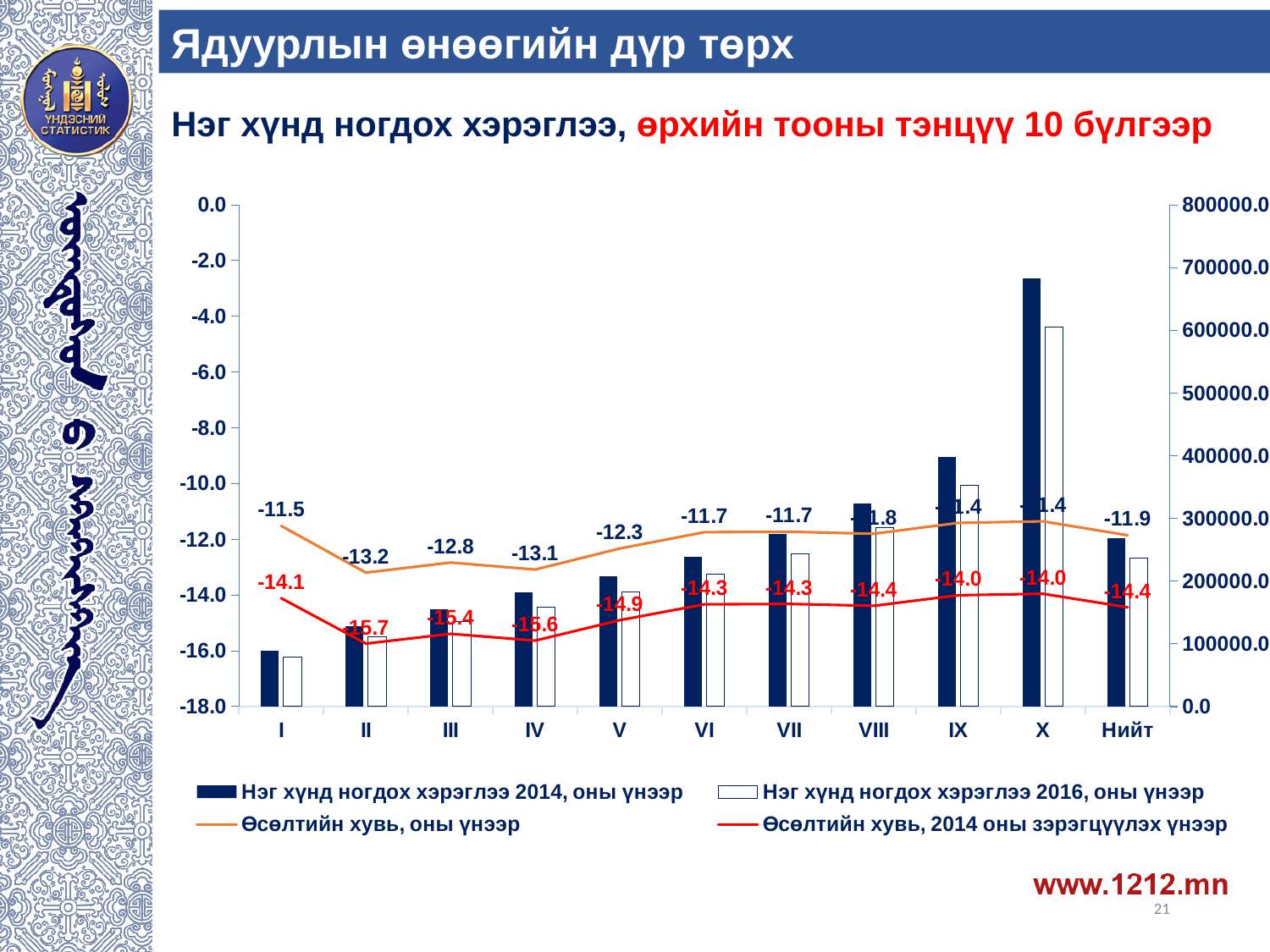
For which group is the 'Өсөлтийн хувь, 2014 оны зэрэгцүүлэх үнээр' line lowest? II How many series does the legend list? 4 For which group is the 'Өсөлтийн хувь, оны үнээр' line lowest? II What is the value of the 'Өсөлтийн хувь, 2014 оны зэрэгцүүлэх үнээр' line for group II? -15.7 How many categories are shown on the x axis? 11 What is the value of the 'Өсөлтийн хувь, оны үнээр' line for group I? -11.5 What is the difference between the 'Өсөлтийн хувь, оны үнээр' values for group I and group II? 1.7 What is the value of the 'Өсөлтийн хувь, оны үнээр' line for Нийт? -11.9 Which group has the tallest 'Нэг хүнд ногдох хэрэглээ 2014, оны үнээр' bar? X Is the 'Нэг хүнд ногдох хэрэглээ 2014, оны үнээр' bar for group X greater or less than 500000.0? greater What is the value of the 'Өсөлтийн хувь, 2014 оны зэрэгцүүлэх үнээр' line for group V? -14.9 Which is larger, the 'Өсөлтийн хувь, оны үнээр' value for group IV or for group V? Group V